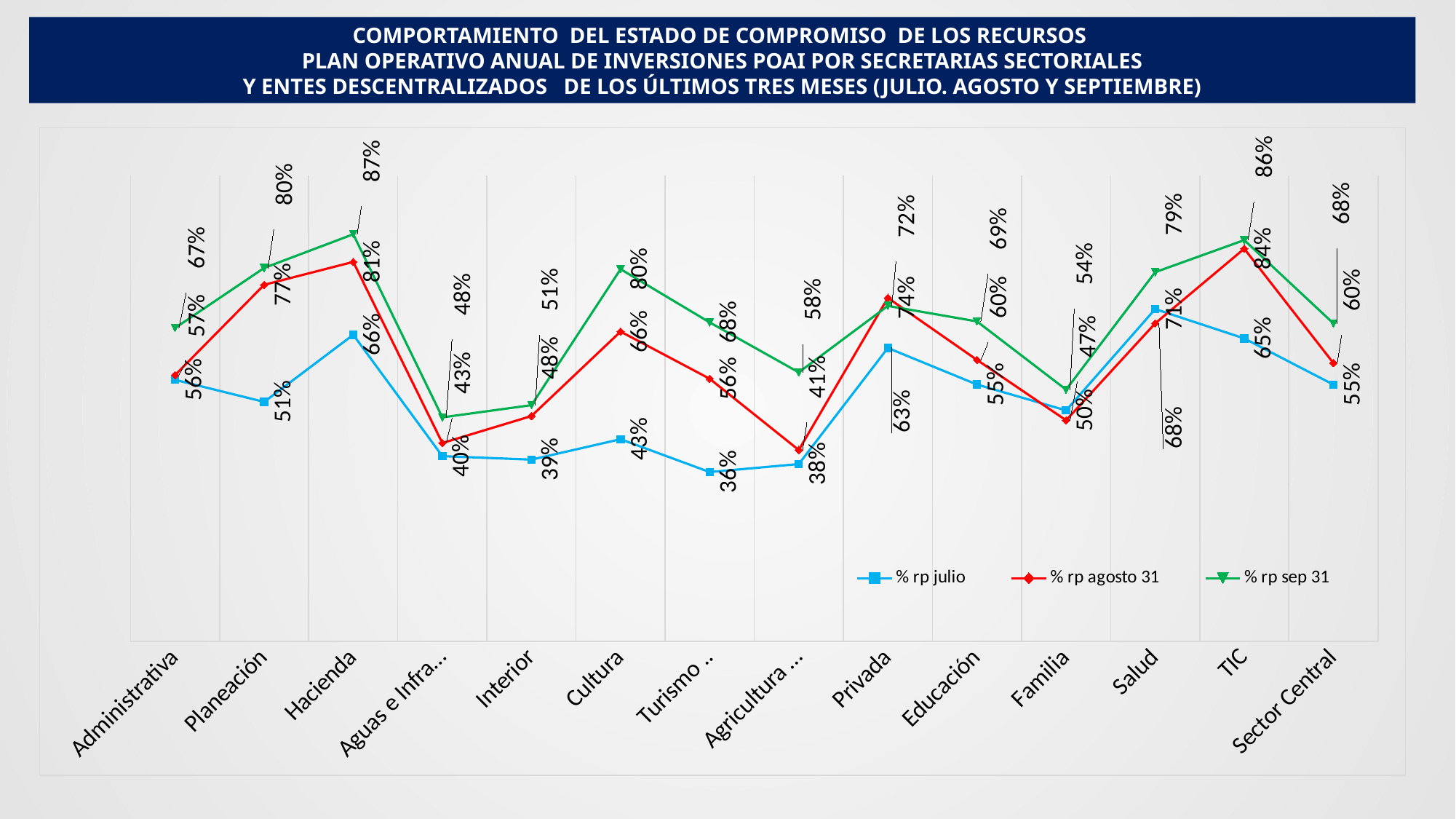
What is the value of % rp sep 31 for Hacienda? 87% Which is larger for Privada: % rp agosto 31 or % rp sep 31? % rp agosto 31 How many categories are shown on the x axis? 14 What is the value of % rp agosto 31 for TIC? 84% What is the value of % rp julio for Salud? 71% Which series is drawn in green in the legend? % rp sep 31 What type of chart is shown on the slide? line chart Which category has the highest % rp sep 31 value? Hacienda Which category has the lowest % rp julio value? Turismo What is the value of % rp julio for Turismo? 36% How many series does the legend list? 3 What is the difference between % rp sep 31 and % rp julio for Cultura? 37%